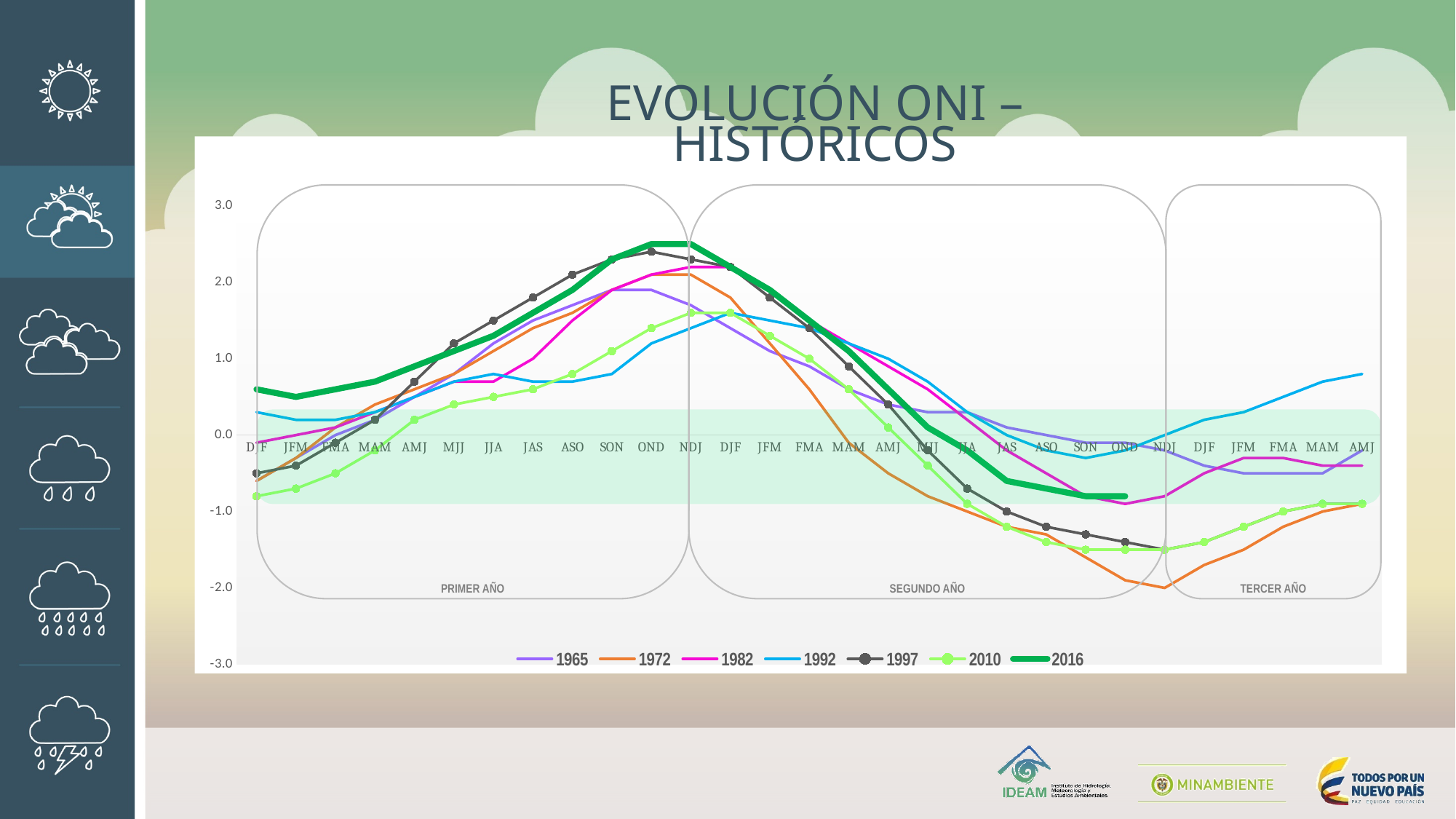
How many year panels (PRIMER AÑO, SEGUNDO AÑO, TERCER AÑO) are marked on the chart? 3 How many series does the legend list? 7 Is the value for 2016 at OND of the first year greater or less than 2.0? greater Is the value for 2010 at DJF of the first year greater or less than 0.0? less Is the value for 1992 at AMJ of the third year greater or less than 0.0? greater What kind of chart is shown on the slide? line chart Which series reaches the lowest value anywhere on the chart? 1972 Does the 2016 series rise or fall from DJF to OND of the first year? rise At OND of the first year, which is larger: the value for 2016 or the value for 2010? 2016 Which years are listed in the chart legend? 1965, 1972, 1982, 1992, 1997, 2010, 2016 What is the title of the slide containing the chart? EVOLUCIÓN ONI – HISTÓRICOS